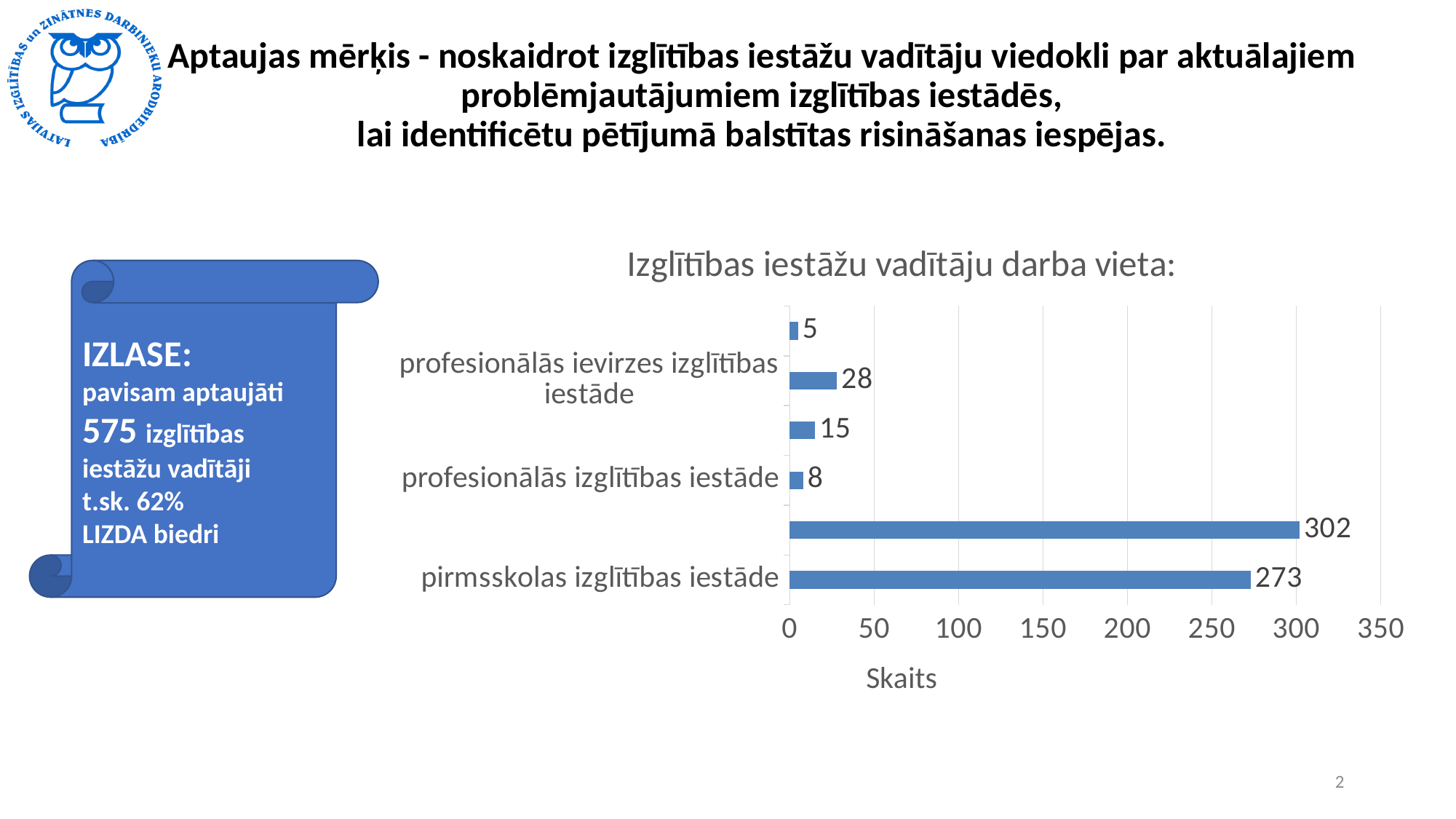
Is the value for "pirmsskolas izglītības iestāde" greater or less than 250? greater Which has a larger value: "profesionālās ievirzes izglītības iestāde" or "profesionālās izglītības iestāde"? profesionālās ievirzes izglītības iestāde What is the value for "profesionālās izglītības iestāde"? 8 What is the difference between the values for "pirmsskolas izglītības iestāde" and "profesionālās izglītības iestāde"? 265 What is the value for "profesionālās ievirzes izglītības iestāde"? 28 What is the title of the chart? Izglītības iestāžu vadītāju darba vieta: What is the largest value shown on the chart? 302 What is the value for "pirmsskolas izglītības iestāde"? 273 What is the label of the horizontal axis? Skaits What kind of chart is shown on the slide? bar chart What is the smallest value shown on the chart? 5 How many bars are plotted on the chart? 6